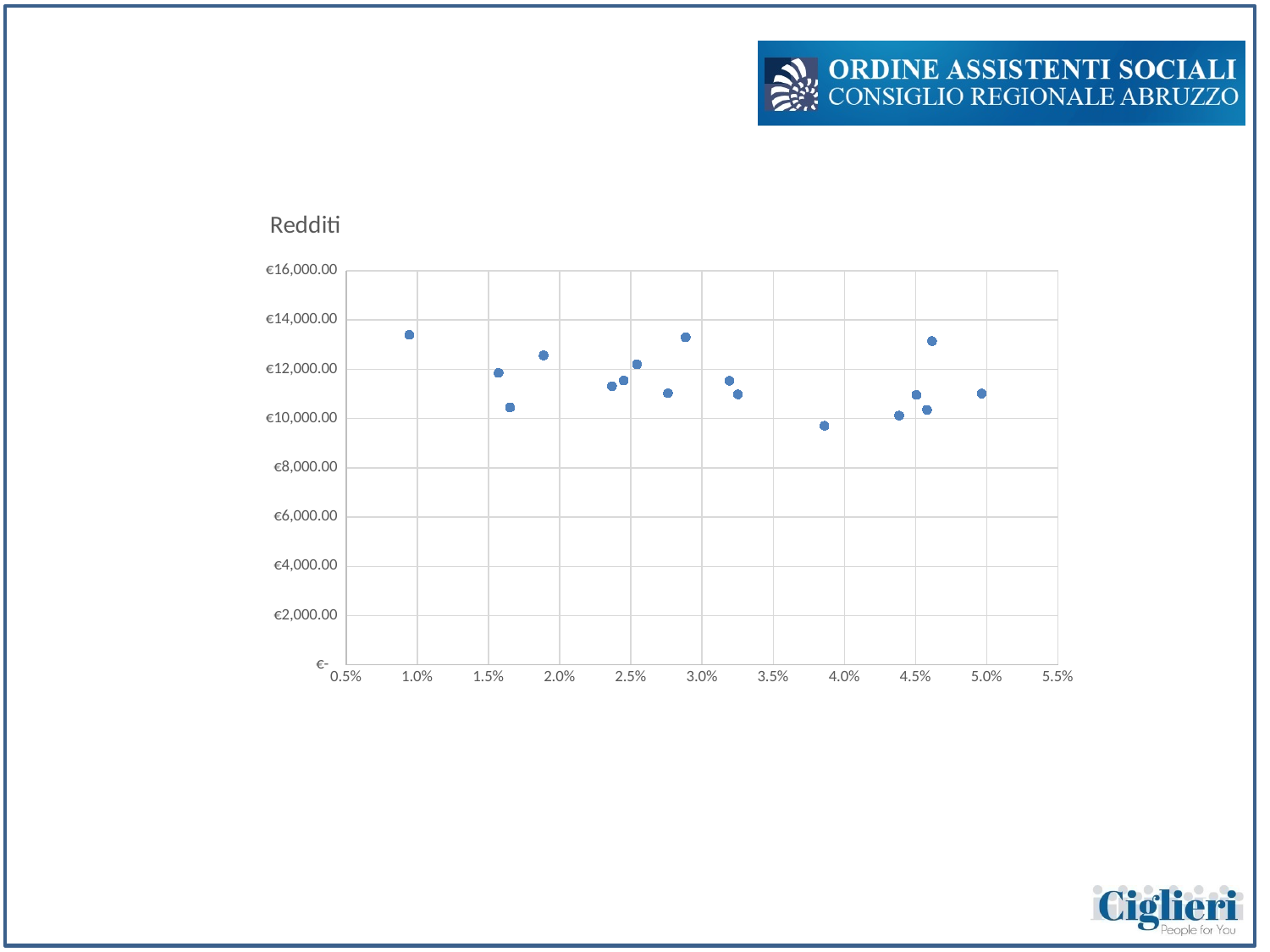
How many data points are plotted in the Redditi chart? 17 Is the point near 4.6% at about €13,000 higher or lower than the point near 4.4%? higher Is the value of the lowest point in the Redditi chart (near 3.9% on the x axis) greater or less than €10,000.00? less Is the value of the point near 1.0% on the x axis greater or less than €12,000.00? greater What is the title of the chart? Redditi Which point has the lowest value in the Redditi chart: the one near 3.9% or the one near 1.0% on the x axis? the one near 3.9% Is the value of the point near 1.9% on the x axis greater or less than €12,000.00? greater What kind of chart is shown on the slide? scatter chart What is the maximum value shown on the y axis of the Redditi chart? €16,000.00